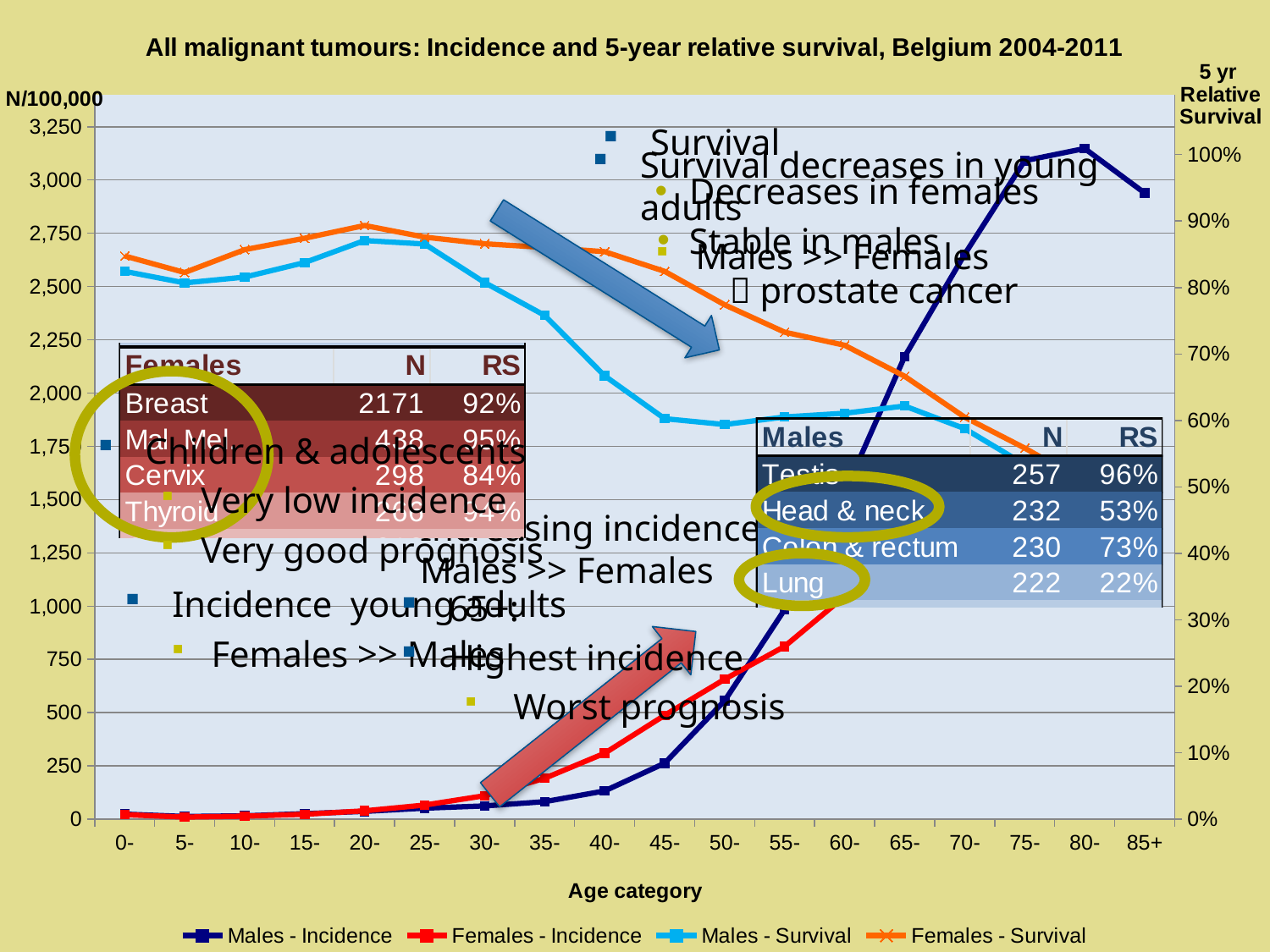
Is the Males - Survival value at age category 45- greater or less than 70%? less What kind of chart is shown on the slide? line chart Does the Males - Incidence series rise or fall from age category 50- to 80-? rise Is the Females - Incidence value at age category 40- greater or less than 500? less What is the title of the x axis of the chart? Age category Is the Males - Incidence value at age category 85+ greater or less than 2,750? greater At age category 40-, which is larger: Males - Incidence or Females - Incidence? Females - Incidence At which age category does the Males - Incidence series reach its highest value? 80- How many series does the chart legend list? 4 How many age categories are shown on the x axis of the chart? 18